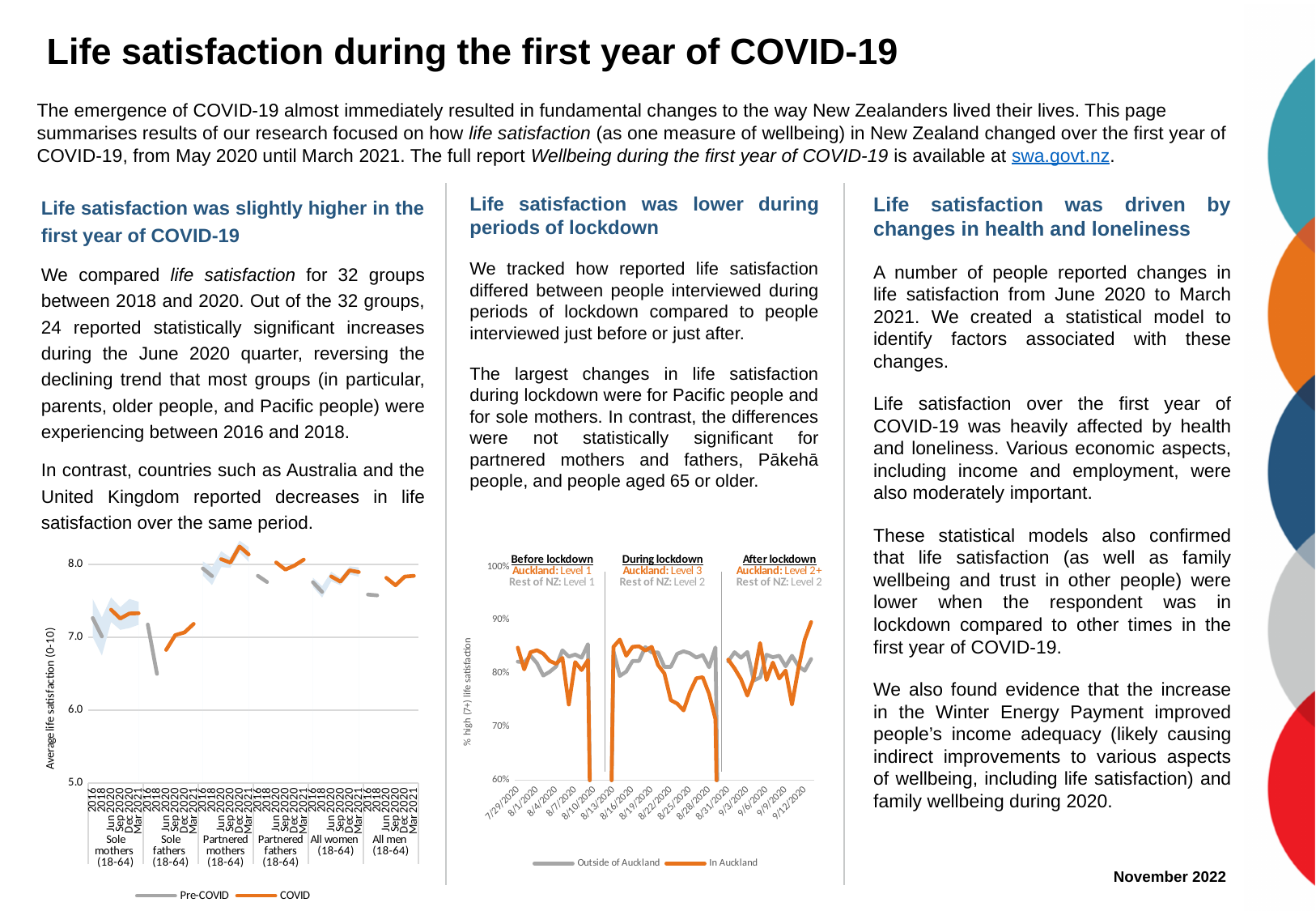
What kind of chart is the left chart showing average life satisfaction by group? line chart On the left chart (average life satisfaction), what are the two legend entries? Pre-COVID and COVID On the middle chart (% high life satisfaction), how many series does the legend list? 2 On the left chart (average life satisfaction), how many series does the legend list? 2 On the left chart (average life satisfaction), are the COVID-period values for sole fathers (18-64) greater or less than 8.0? less On the middle chart (% high life satisfaction), is the In Auckland value at the final date (9/12/2020) greater or less than 80%? greater On the left chart (average life satisfaction), how many population groups are shown along the x axis? 6 On the left chart (average life satisfaction), which group has the lowest life satisfaction values? Sole fathers (18-64) On the left chart (average life satisfaction), what is the label of the y axis? Average life satisfaction (0-10) What kind of chart is the middle chart showing % high (7+) life satisfaction in and outside Auckland? line chart On the left chart (average life satisfaction), are the COVID-period values for sole mothers (18-64) greater or less than 7.0? greater